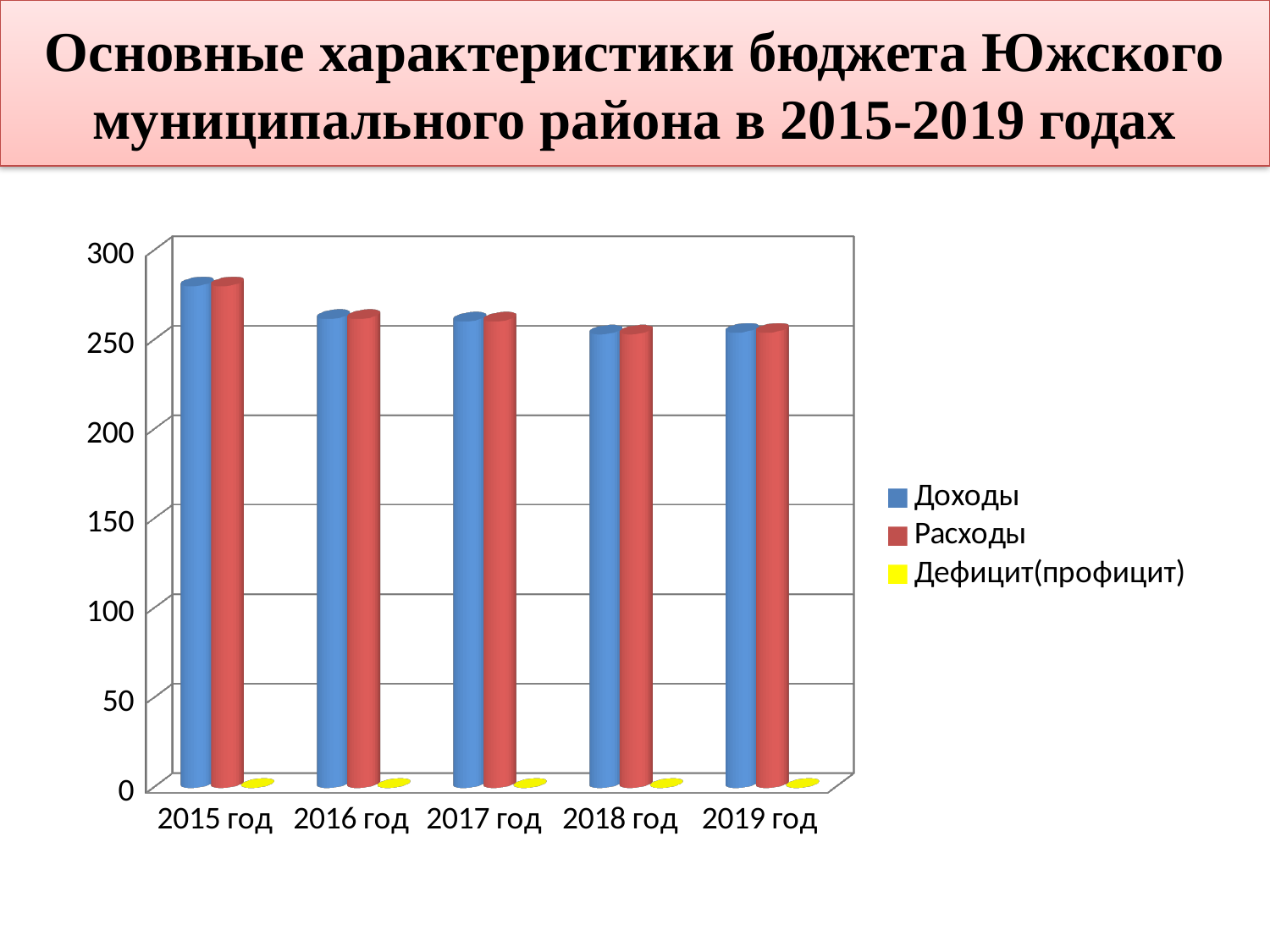
What kind of chart is shown on the slide? bar chart Do the values for Доходы generally rise or fall from 2015 год to 2019 год? fall Which is larger: Доходы in 2015 год or Доходы in 2018 год? 2015 год Is the value for Доходы in 2015 год greater or less than 250? greater Which colour represents the Расходы series in the legend? red How many years (categories) are shown on the x axis? 5 In which year is the value for Расходы highest? 2015 год How many series does the legend list? 3 Is the value for Расходы in 2018 год greater or less than 300? less Which series is shown in yellow in the legend? Дефицит(профицит) Is the value for Дефицит(профицит) in 2017 год greater or less than 50? less In which year is the value for Доходы highest? 2015 год